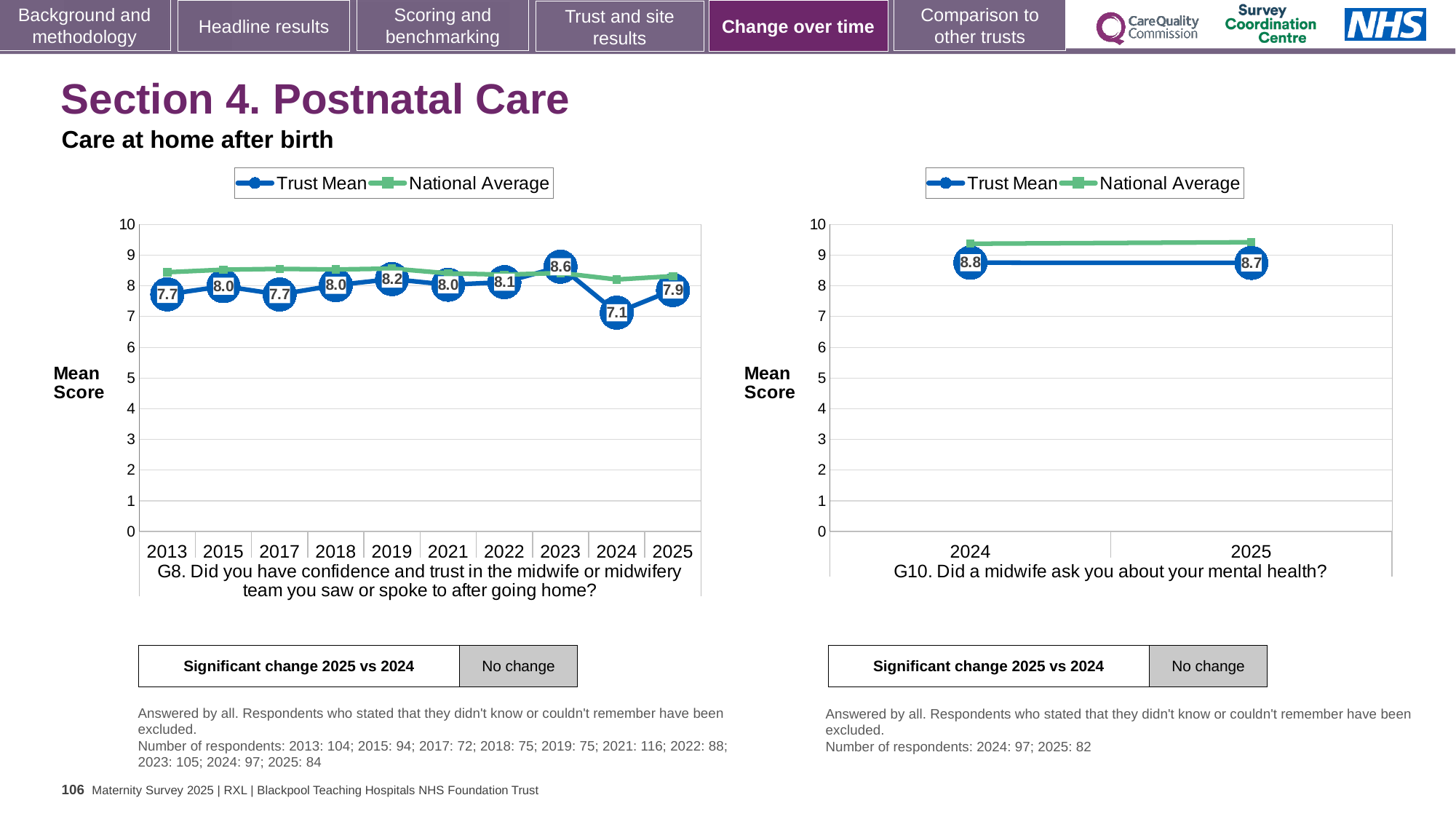
In the G8 chart, what is the difference between the Trust Mean in 2023 and in 2024? 1.5 In the G8 chart, what is the Trust Mean for 2025? 7.9 In the G8 chart, which year has the lowest Trust Mean? 2024 In the G8 chart, what is the Trust Mean for 2023? 8.6 In the G8 chart, is the National Average for 2024 greater or less than 7? greater How many series does the legend of the G10 chart list? 2 In the G10 chart, what is the Trust Mean for 2024? 8.8 In the G8 chart, how many years are shown on the x axis? 10 In the G8 chart, what is the Trust Mean for 2024? 7.1 In the G8 chart, which year has the highest Trust Mean? 2023 In the G10 chart, which year has the larger Trust Mean, 2024 or 2025? 2024 In the G10 chart, is the National Average for 2025 greater or less than 9? greater